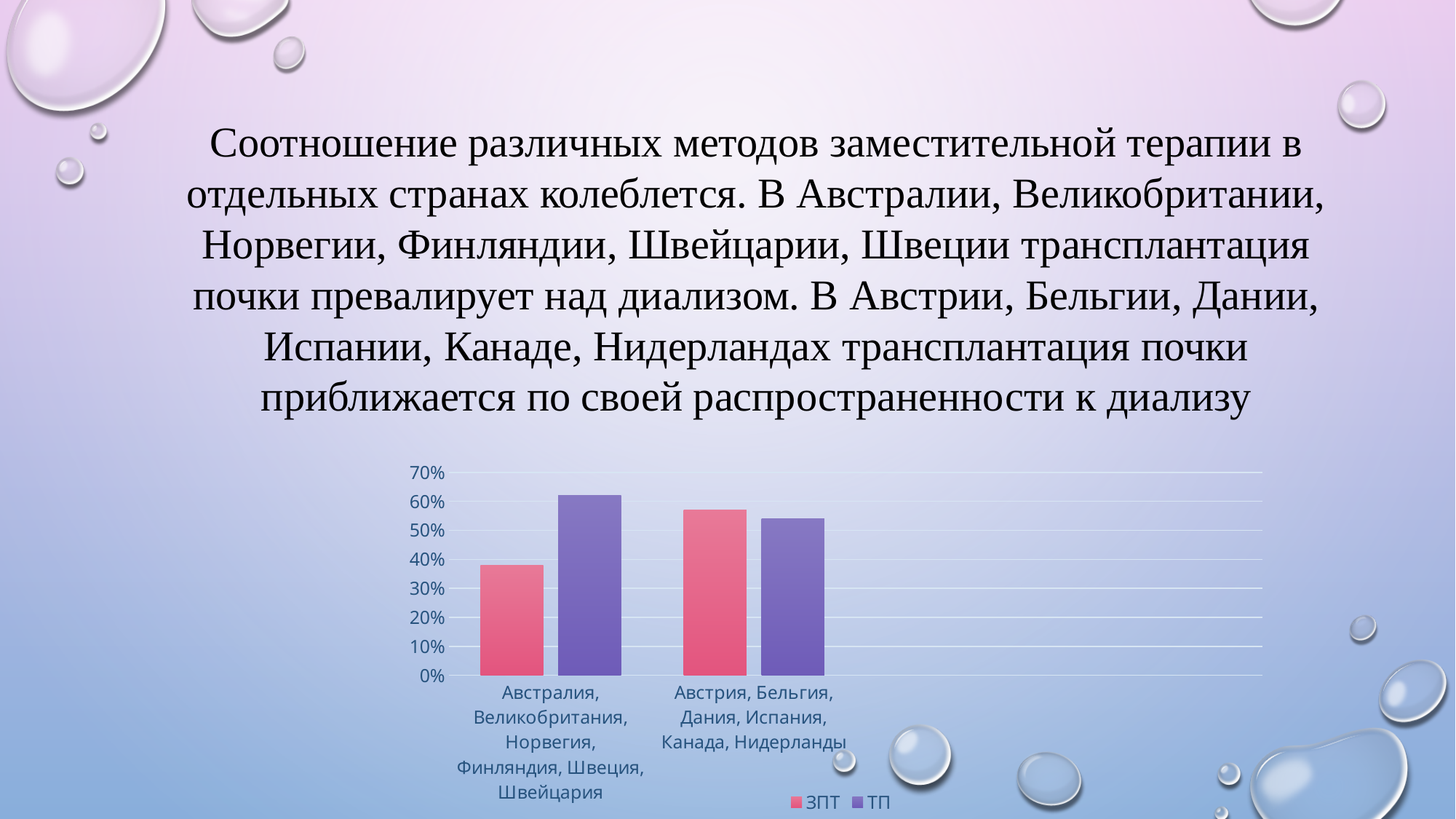
What are the two series named in the chart legend? ЗПТ and ТП What kind of chart is shown on the slide? bar chart Is the ЗПТ value for the group 'Австралия, Великобритания, Норвегия, Финляндия, Швеция, Швейцария' greater or less than 50%? less How many series does the chart legend list? 2 Is the ТП value for the group 'Австрия, Бельгия, Дания, Испания, Канада, Нидерланды' greater or less than 40%? greater For the group 'Австралия, Великобритания, Норвегия, Финляндия, Швеция, Швейцария', which series has the larger value, ЗПТ or ТП? ТП Is the ТП value for the group 'Австралия, Великобритания, Норвегия, Финляндия, Швеция, Швейцария' greater or less than 50%? greater Which bar in the chart is the highest? ТП for Австралия, Великобритания, Норвегия, Финляндия, Швеция, Швейцария Which colour represents the ТП series in the chart? purple Which bar in the chart is the lowest? ЗПТ for Австралия, Великобритания, Норвегия, Финляндия, Швеция, Швейцария How many country groups (categories) are shown on the x axis of the chart? 2